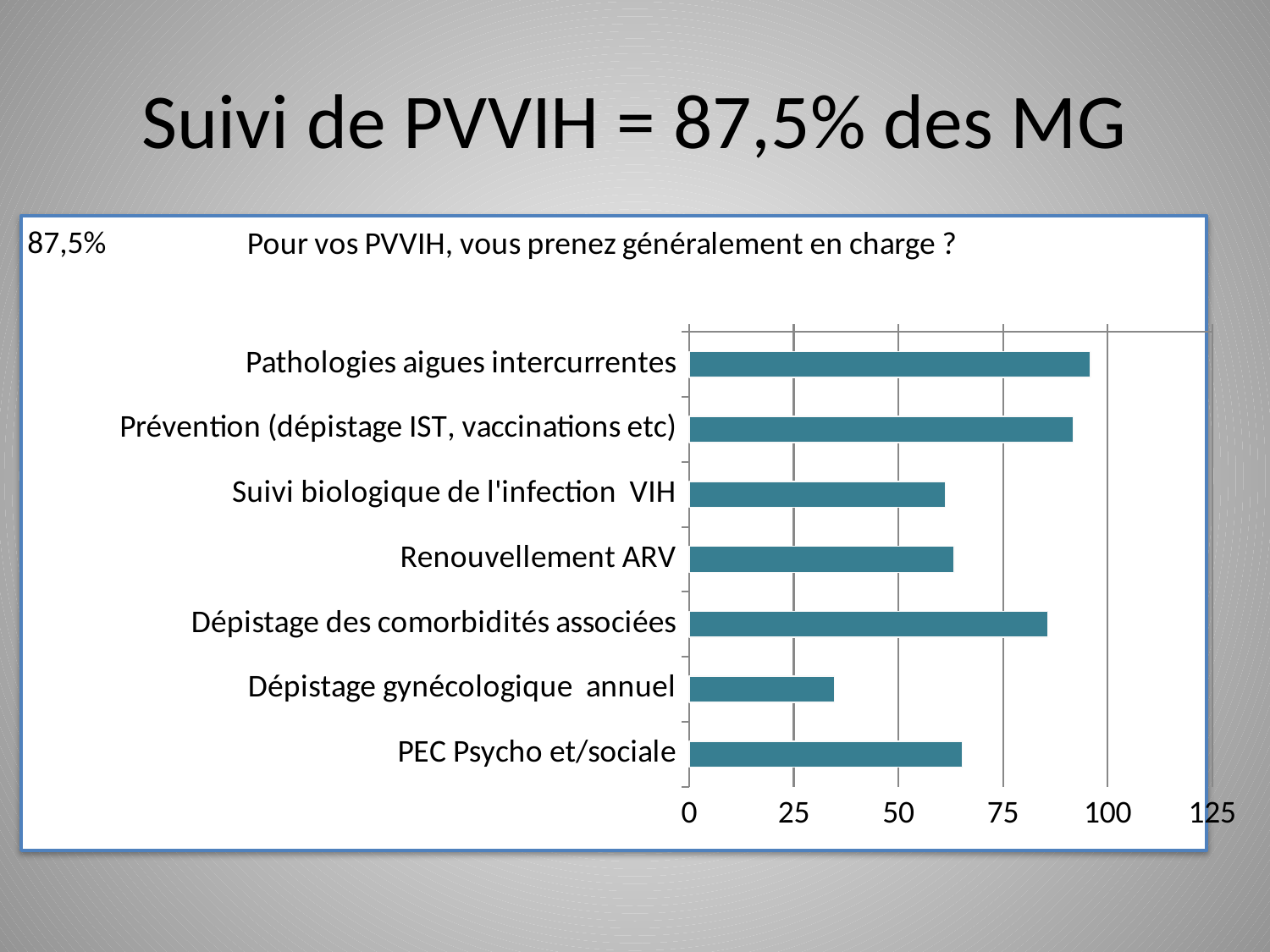
Is the value for PEC Psycho et/sociale greater or less than 75? less What kind of chart is shown on the slide? bar chart Which is larger, the value for Prévention (dépistage IST, vaccinations etc) or the value for Dépistage gynécologique annuel? Prévention (dépistage IST, vaccinations etc) Is the value for Dépistage gynécologique annuel greater or less than 50? less How many categories are plotted in the chart? 7 Is the value for Suivi biologique de l'infection VIH greater or less than 50? greater Which is larger, the value for Dépistage des comorbidités associées or the value for Renouvellement ARV? Dépistage des comorbidités associées What is the title of the chart? Pour vos PVVIH, vous prenez généralement en charge ? Which category has the lowest value in the chart? Dépistage gynécologique annuel